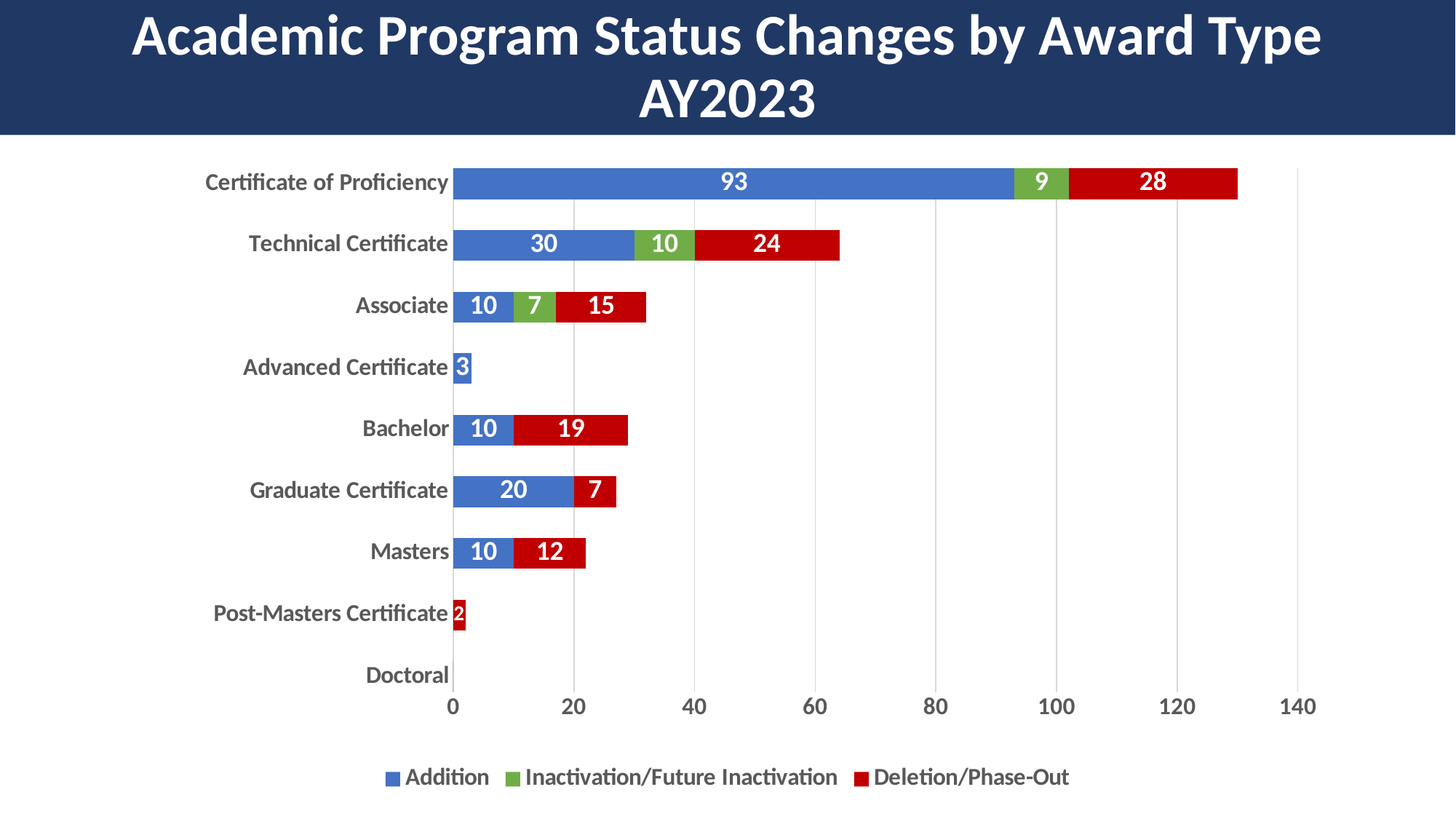
What is the Inactivation/Future Inactivation value for Associate? 7 What is the Addition value for Certificate of Proficiency? 93 Which is larger, the Addition value for Technical Certificate or the Addition value for Graduate Certificate? Technical Certificate What is the difference between the Deletion/Phase-Out values for Bachelor and Masters? 7 Is the total stacked bar for Certificate of Proficiency greater or less than 120? greater What is the total of the stacked bar for Technical Certificate? 64 What is the Deletion/Phase-Out value for Technical Certificate? 24 How many series does the legend list? 3 How many award types are listed on the y axis? 9 Which award type has the highest Addition value? Certificate of Proficiency What kind of chart is shown on the slide? Stacked bar chart Which award type has the lowest Deletion/Phase-Out value among those with a labeled Deletion/Phase-Out segment? Post-Masters Certificate